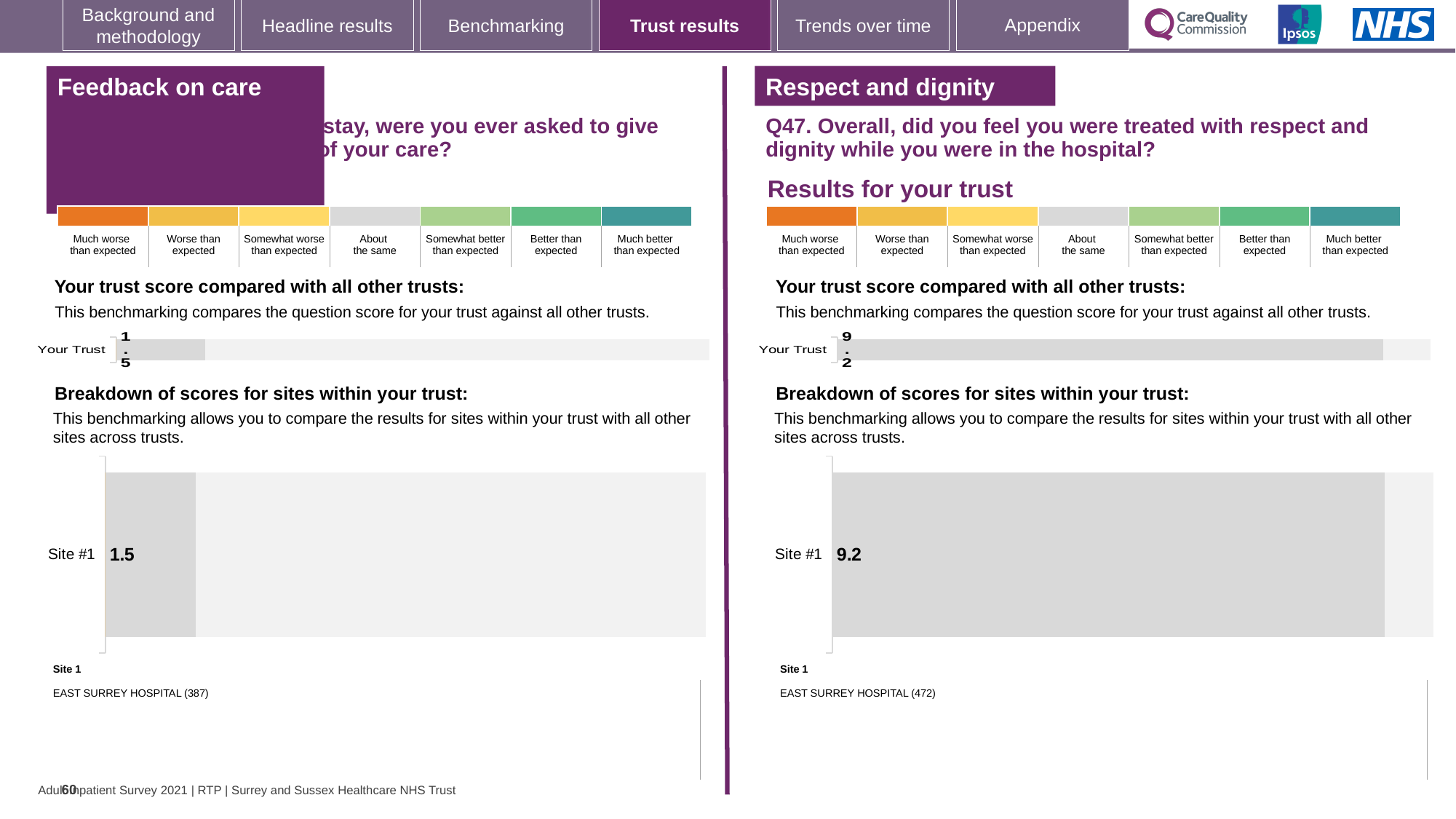
Is the Your Trust score in the 'Feedback on care' section greater or less than the Your Trust score in the 'Respect and dignity' section? less In the 'Respect and dignity' section, what is the score shown for Your Trust in the trust score chart? 9.2 In the 'Feedback on care' section, what is the score shown for Your Trust in the trust score chart? 1.5 In the 'Respect and dignity' section, which hospital is listed as Site 1 below the breakdown chart? EAST SURREY HOSPITAL (472) In the 'Feedback on care' section, what is the score shown for Site #1 in the breakdown of scores chart? 1.5 Which is larger: the Site #1 score in the 'Respect and dignity' section or the Site #1 score in the 'Feedback on care' section? Respect and dignity How many sites are shown in the breakdown of scores chart in the 'Respect and dignity' section? 1 What is the difference between the Your Trust score in the 'Respect and dignity' section and the Your Trust score in the 'Feedback on care' section? 7.7 How many sites are shown in the breakdown of scores chart in the 'Feedback on care' section? 1 In the 'Feedback on care' section, which hospital is listed as Site 1 below the breakdown chart? EAST SURREY HOSPITAL (387) In the 'Respect and dignity' section, what is the score shown for Site #1 in the breakdown of scores chart? 9.2 What kind of chart is used to show the Site #1 score in the 'Feedback on care' section? Bar chart